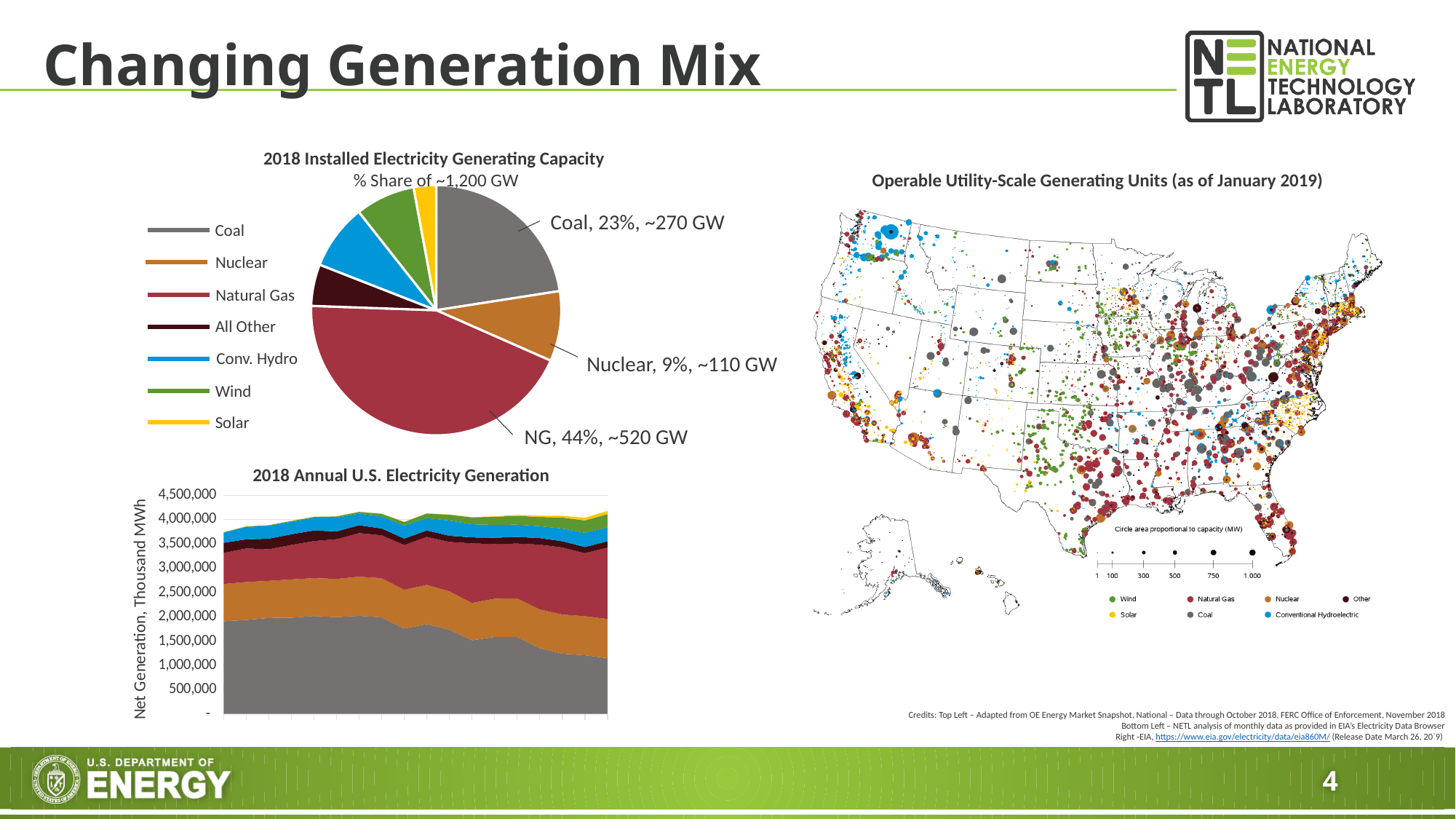
What kind of chart is the 2018 Annual U.S. Electricity Generation chart? Stacked area chart In the 2018 Installed Electricity Generating Capacity pie chart, what share does Nuclear have? 9% In the 2018 Installed Electricity Generating Capacity pie chart, which category has the largest slice? Natural Gas In the 2018 Annual U.S. Electricity Generation chart, does the Coal (bottom, grey) layer rise or fall from left to right? Fall In the 2018 Installed Electricity Generating Capacity pie chart, what share does NG (Natural Gas) have? 44% What is the y-axis label of the 2018 Annual U.S. Electricity Generation chart? Net Generation, Thousand MWh What kind of chart is the 2018 Installed Electricity Generating Capacity chart? Pie chart In the 2018 Installed Electricity Generating Capacity pie chart, which category has the smallest slice? Solar In the 2018 Installed Electricity Generating Capacity pie chart, how many percentage points larger is the Coal share than the Nuclear share? 14 In the 2018 Installed Electricity Generating Capacity pie chart, which is larger, the Coal share or the Nuclear share? Coal How many categories does the legend of the 2018 Installed Electricity Generating Capacity pie chart list? 7 In the 2018 Installed Electricity Generating Capacity pie chart, what share does Coal have? 23%